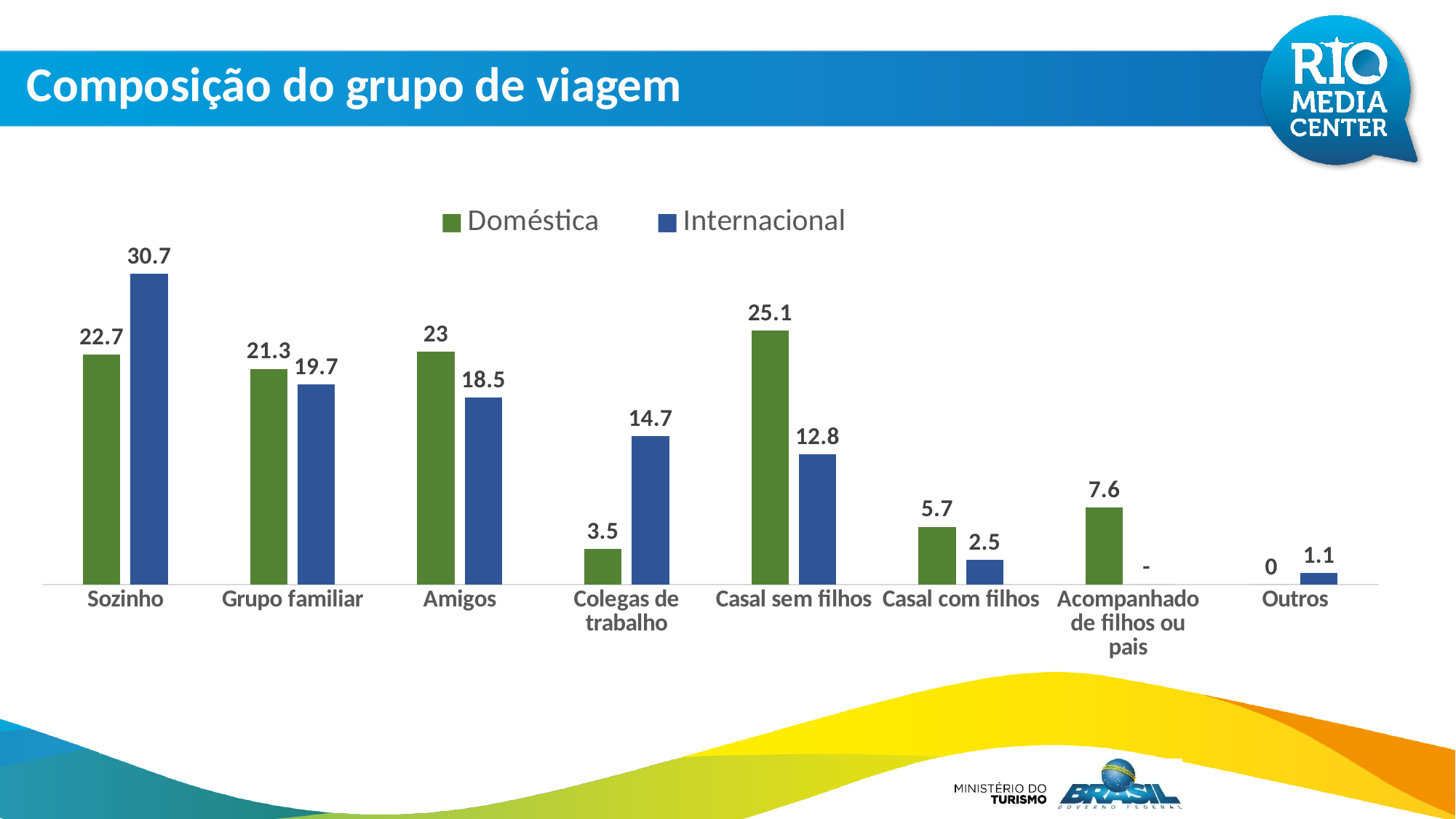
How many series does the legend list? 2 What is the difference between the Internacional and Doméstica values for Sozinho? 8 What is the Doméstica value for Acompanhado de filhos ou pais? 7.6 For Amigos, which series has the larger value, Doméstica or Internacional? Doméstica What is the difference between the Doméstica and Internacional values for Casal sem filhos? 12.3 What is the Internacional value for Colegas de trabalho? 14.7 What is the Doméstica value for Sozinho? 22.7 Which category has the highest Internacional value? Sozinho What is the title of the slide? Composição do grupo de viagem How many categories are shown on the x axis? 8 Which category has the lowest Doméstica value? Outros What kind of chart is shown on the slide? Bar chart